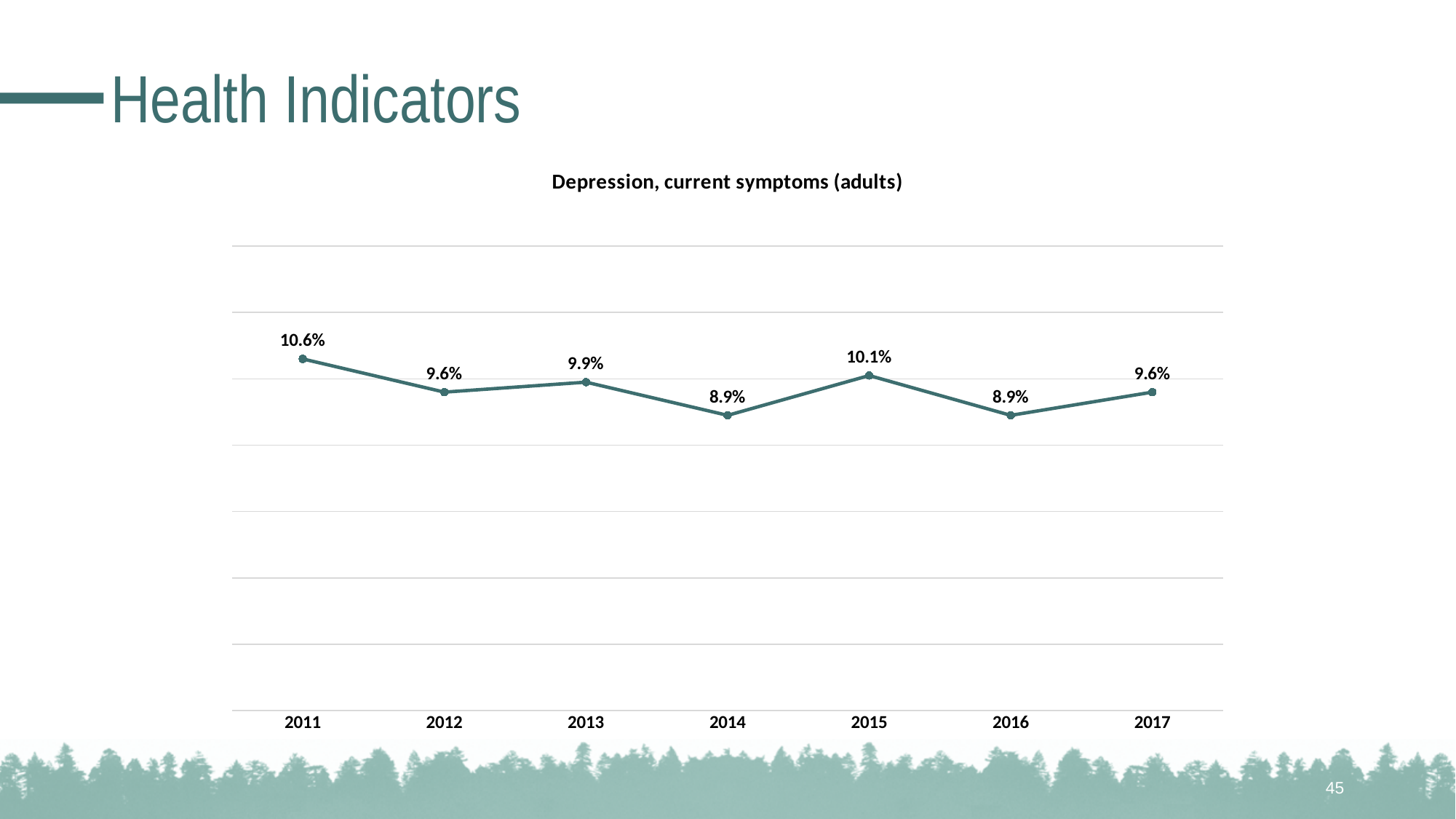
What is the title of the chart? Depression, current symptoms (adults) What kind of chart is shown? line chart How many years are plotted on the chart? 7 What is the value for 2015? 10.1% What is the difference between the values for 2011 and 2014? 1.7% What is the value for 2017? 9.6% Which is larger, the value for 2011 or the value for 2015? 2011 What is the difference between the values for 2015 and 2016? 1.2% Which year has the highest value? 2011 Which is larger, the value for 2013 or the value for 2016? 2013 What is the value for 2014? 8.9% What is the value for 2011? 10.6%